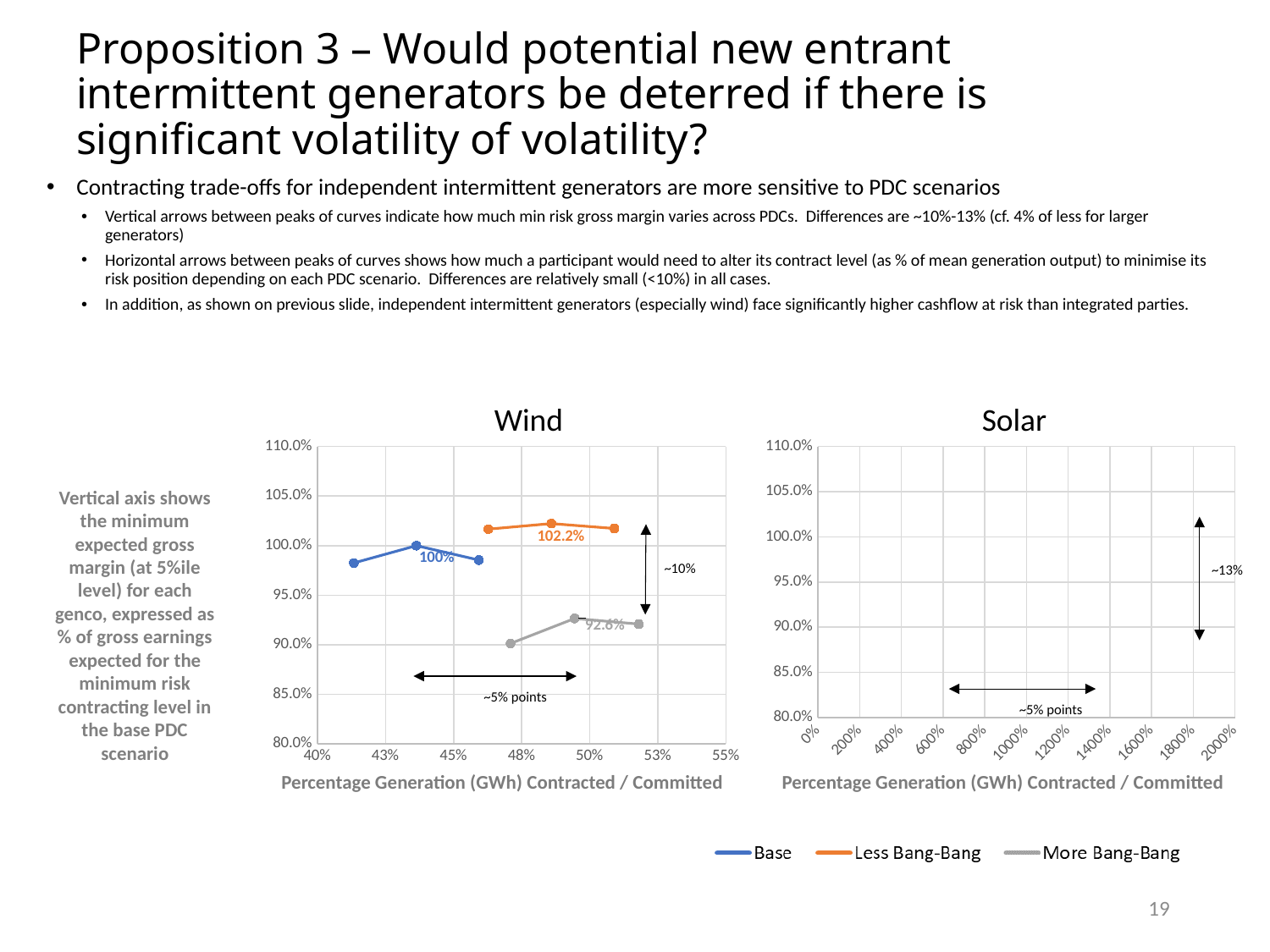
In the Wind chart, which series has the lowest peak value? More Bang-Bang In the Wind chart, what is the labelled peak value of the Base series? 100% In the Wind chart, what is the labelled peak value of the Less Bang-Bang series? 102.2% What type of chart is the Wind chart? line chart In the Wind chart, which has the larger labelled peak, Base or More Bang-Bang? Base In the Wind chart, what is the difference between the labelled peak of Less Bang-Bang and the labelled peak of Base? 2.2% What is the x-axis title of the Wind chart? Percentage Generation (GWh) Contracted / Committed In the Wind chart, how many data points does the Base series have? 3 How many series does the legend list? 3 In the Wind chart, which series has the highest peak value? Less Bang-Bang In the Wind chart, are the values of the More Bang-Bang series greater or less than 95.0%? less In the Wind chart, what is the labelled peak value of the More Bang-Bang series? 92.6%